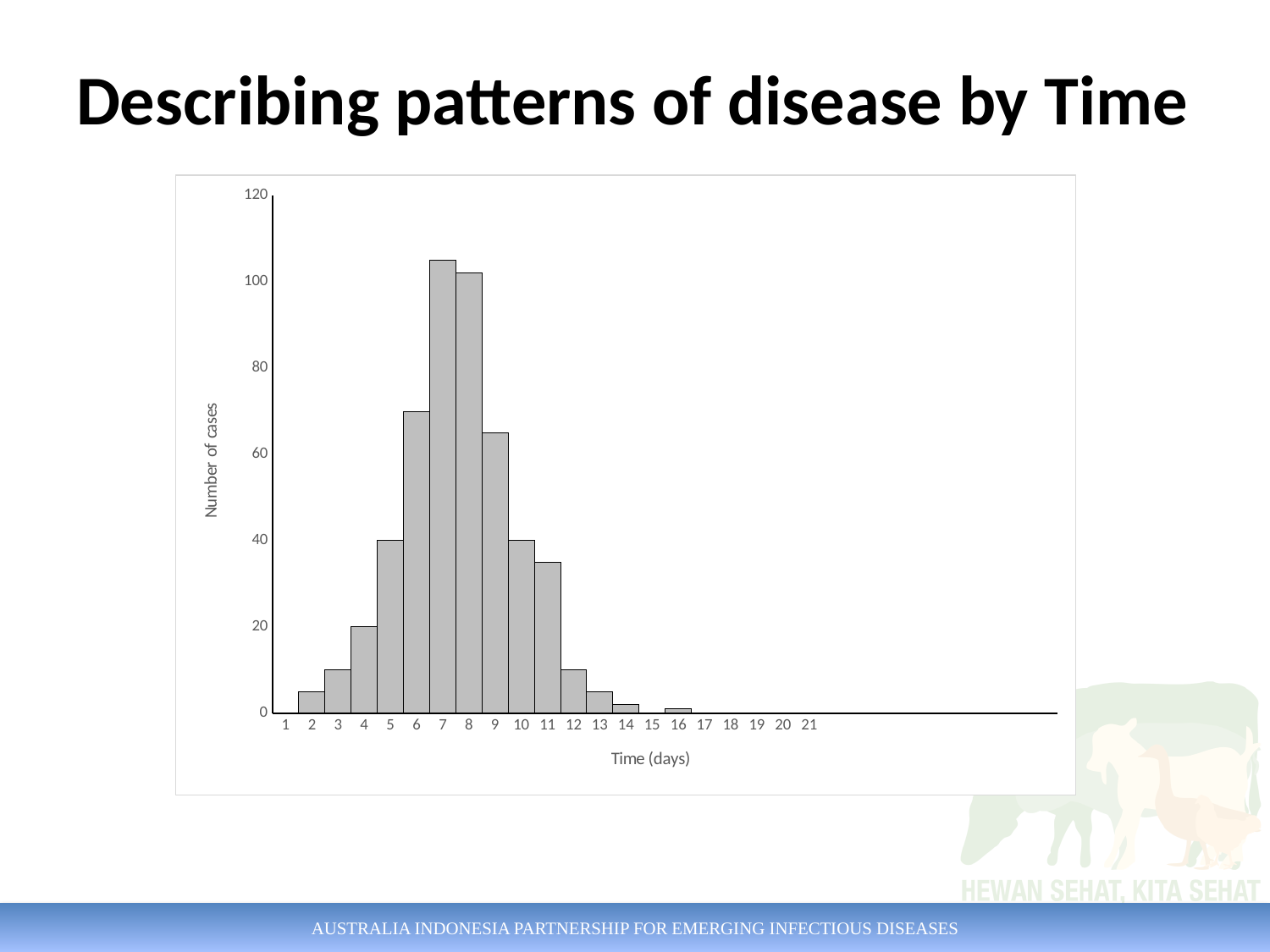
How many days are labelled on the x axis? 21 Is the number of cases on day 11 greater or less than 40? less Is the number of cases on day 7 greater or less than 100? greater On which day is the number of cases highest? 7 What is the number of cases on day 5? 40 What is the label of the y axis? Number of cases Which day has more cases, day 4 or day 12? day 4 What is the number of cases on day 10? 40 Is the number of cases on day 12 greater or less than 20? less What kind of chart is shown on the slide? bar chart What is the number of cases on day 4? 20